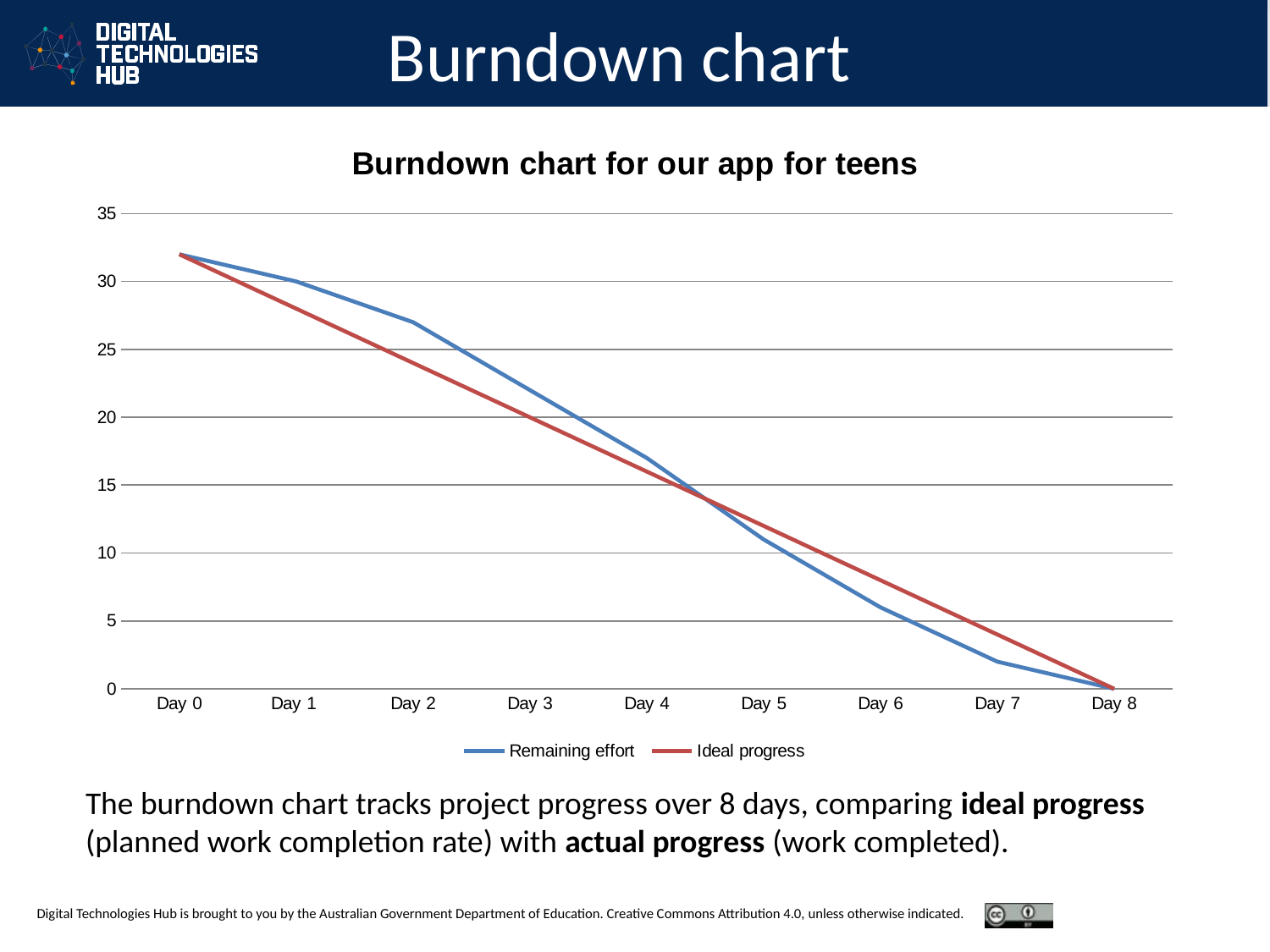
What is the Remaining effort value on Day 8? 0 On which day is Ideal progress lowest? Day 8 On which day is Remaining effort highest? Day 0 Do the Remaining effort values rise or fall from Day 0 to Day 8? fall How many days (points) are plotted along the x axis? 9 Is the Remaining effort value on Day 2 greater or less than 25? greater What is the title of the chart? Burndown chart for our app for teens Is the Remaining effort value on Day 7 greater or less than 5? less What kind of chart is shown on the slide? line chart On Day 2, which series has the higher value, Remaining effort or Ideal progress? Remaining effort On Day 6, which series has the higher value, Remaining effort or Ideal progress? Ideal progress How many series does the legend list? 2